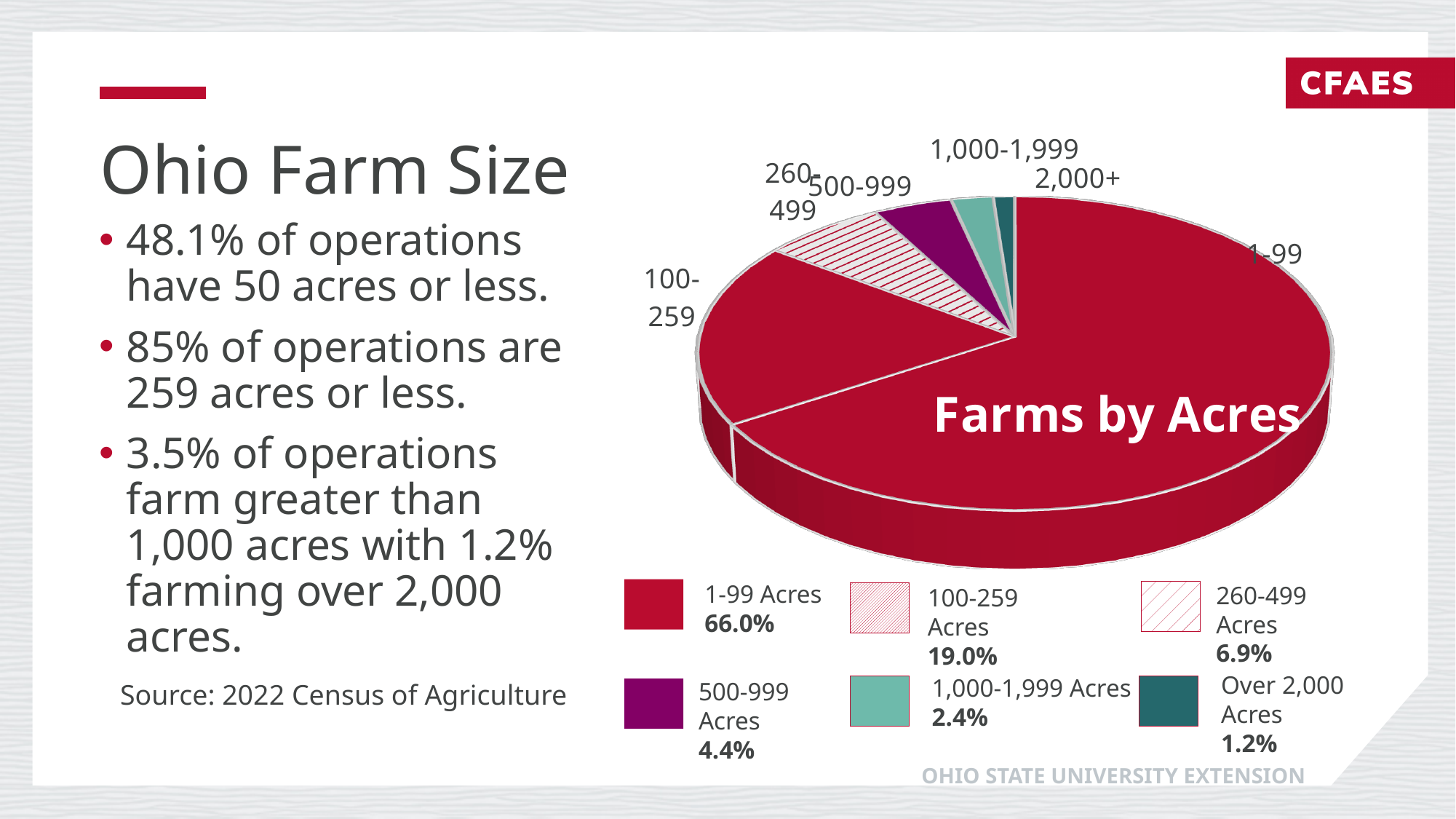
What percentage of farms are 500-999 acres? 4.4% Which is larger, the share for 500-999 Acres or the share for 1,000-1,999 Acres? 500-999 Acres What type of chart is used to show Farms by Acres? Pie chart Which farm size category has the largest share of the pie? 1-99 Acres What is the title shown on the chart? Farms by Acres What percentage of farms are over 2,000 acres? 1.2% How many percentage points larger is the 1-99 Acres share than the 100-259 Acres share? 47.0 What percentage of farms are 260-499 acres? 6.9% How many categories does the Farms by Acres pie chart show? 6 Which farm size category has the smallest share of the pie? Over 2,000 Acres What percentage of farms are 100-259 acres? 19.0% What share of farms are 1-99 acres according to the Farms by Acres pie chart? 66.0%